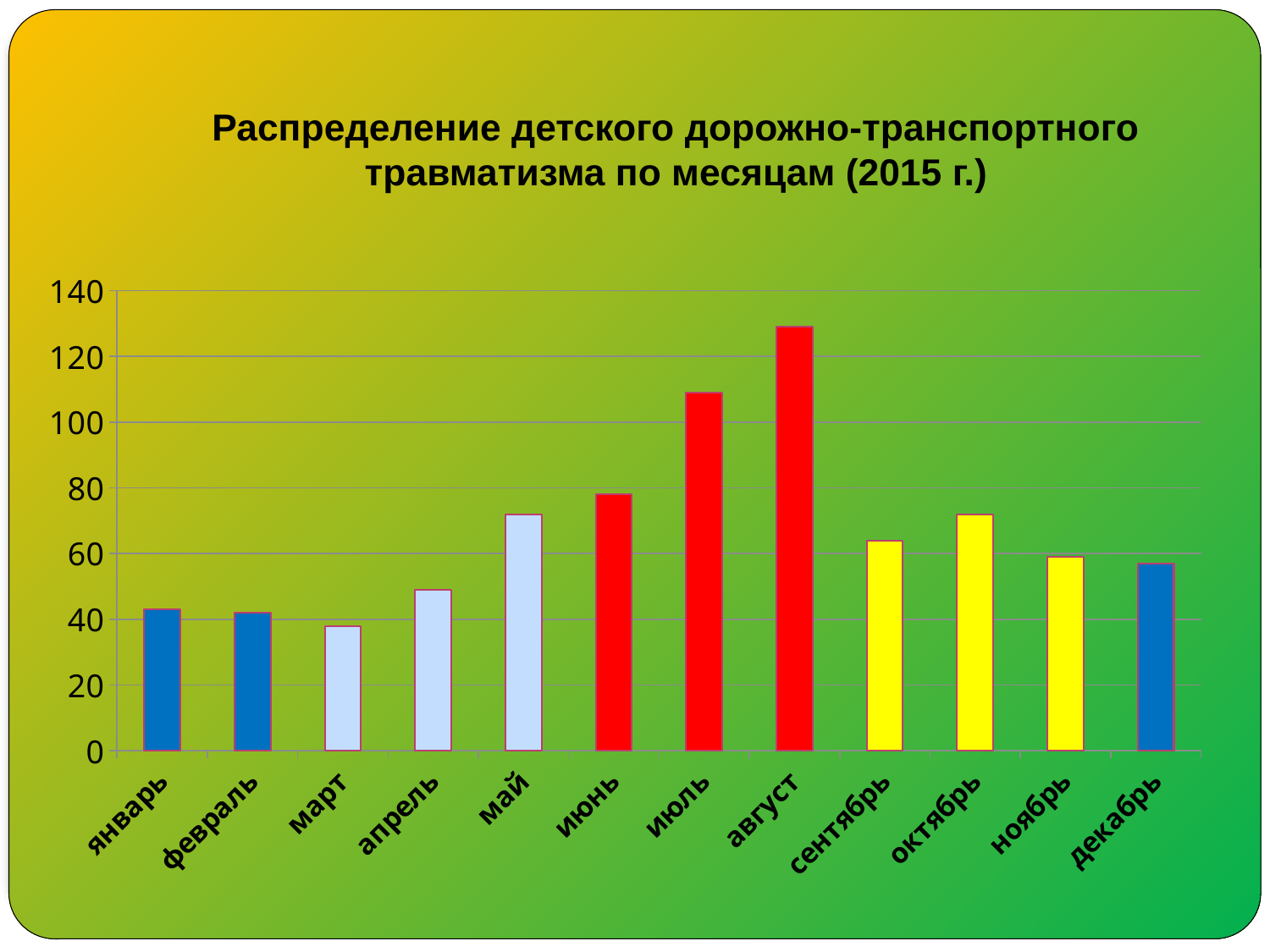
What kind of chart is shown on the slide? bar chart Which is larger, the value for июнь or the value for сентябрь? июнь What is the title of the chart? Распределение детского дорожно-транспортного травматизма по месяцам (2015 г.) Do the values rise or fall from апрель to август? rise How many months (categories) are shown on the x axis? 12 Is the value for март greater or less than 40? less Is the value for июль greater or less than 100? greater Which month has the highest value? август Which month has the lowest value? март Is the value for май greater or less than 60? greater